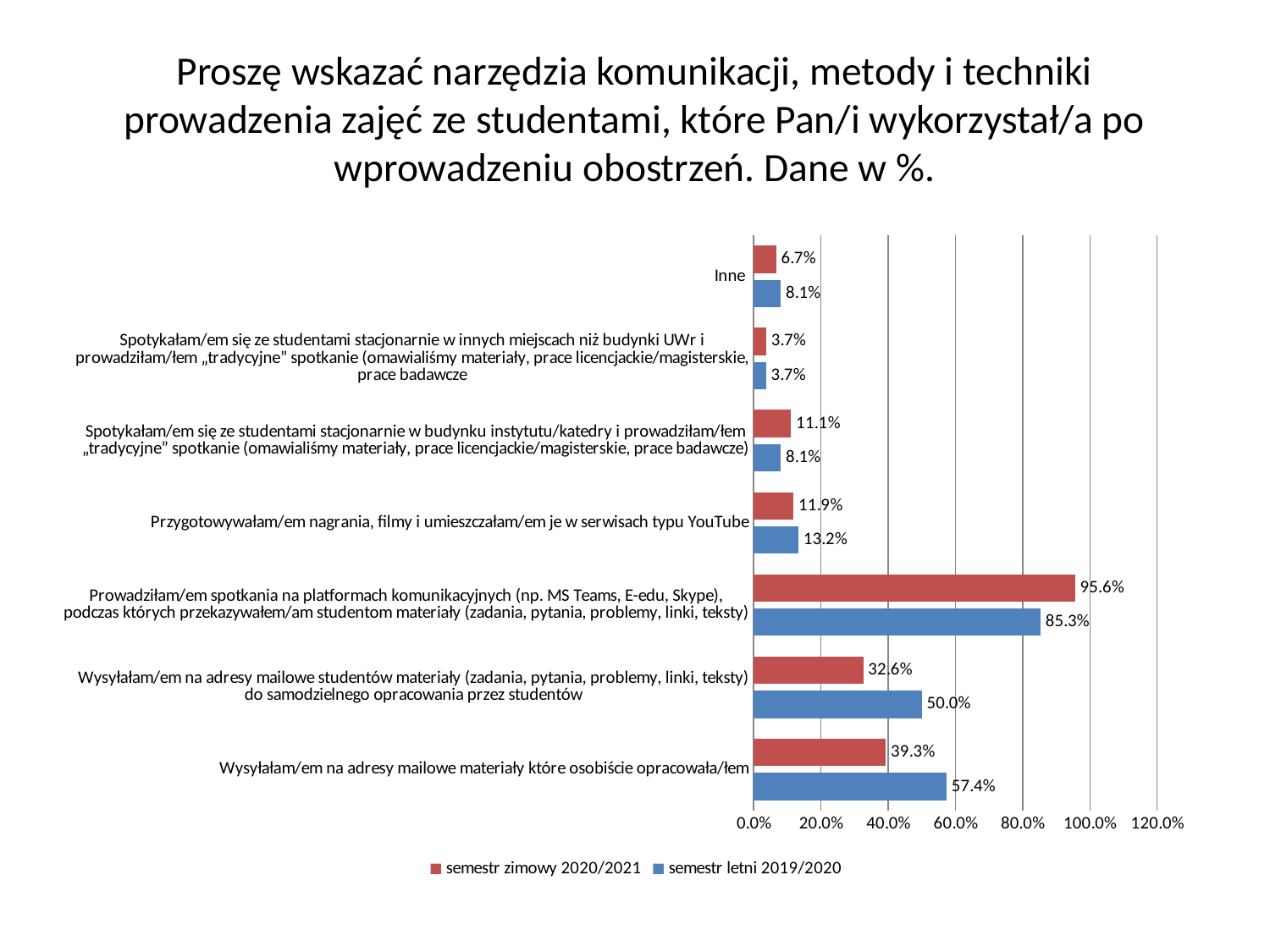
What is the value for 'Wysyłałam/em na adresy mailowe materiały które osobiście opracowała/łem' in the 'semestr zimowy 2020/2021' series? 39.3% Which colour represents the 'semestr letni 2019/2020' series? blue For 'Wysyłałam/em na adresy mailowe studentów materiały (zadania, pytania, problemy, linki, teksty) do samodzielnego opracowania przez studentów', which series has the larger value? semestr letni 2019/2020 What is the difference between the 'semestr zimowy 2020/2021' and 'semestr letni 2019/2020' values for 'Prowadziłam/em spotkania na platformach komunikacyjnych'? 10.3% Which category has the lowest value in the 'semestr zimowy 2020/2021' series? Spotykałam/em się ze studentami stacjonarnie w innych miejscach niż budynki UWr i prowadziłam/łem „tradycyjne” spotkanie (omawialiśmy materiały, prace licencjackie/magisterskie, prace badawcze How many series does the legend list? 2 What is the value for 'Inne' in the 'semestr zimowy 2020/2021' series? 6.7% Which category has the highest value in the 'semestr letni 2019/2020' series? Prowadziłam/em spotkania na platformach komunikacyjnych (np. MS Teams, E-edu, Skype), podczas których przekazywałem/am studentom materiały (zadania, pytania, problemy, linki, teksty) How many categories are plotted on the chart? 7 What is the value for 'Przygotowywałam/em nagrania, filmy i umieszczałam/em je w serwisach typu YouTube' in the 'semestr letni 2019/2020' series? 13.2% What kind of chart is shown on the slide? bar chart Is the 'semestr letni 2019/2020' value for 'Wysyłałam/em na adresy mailowe materiały które osobiście opracowała/łem' greater or less than 40.0%? greater